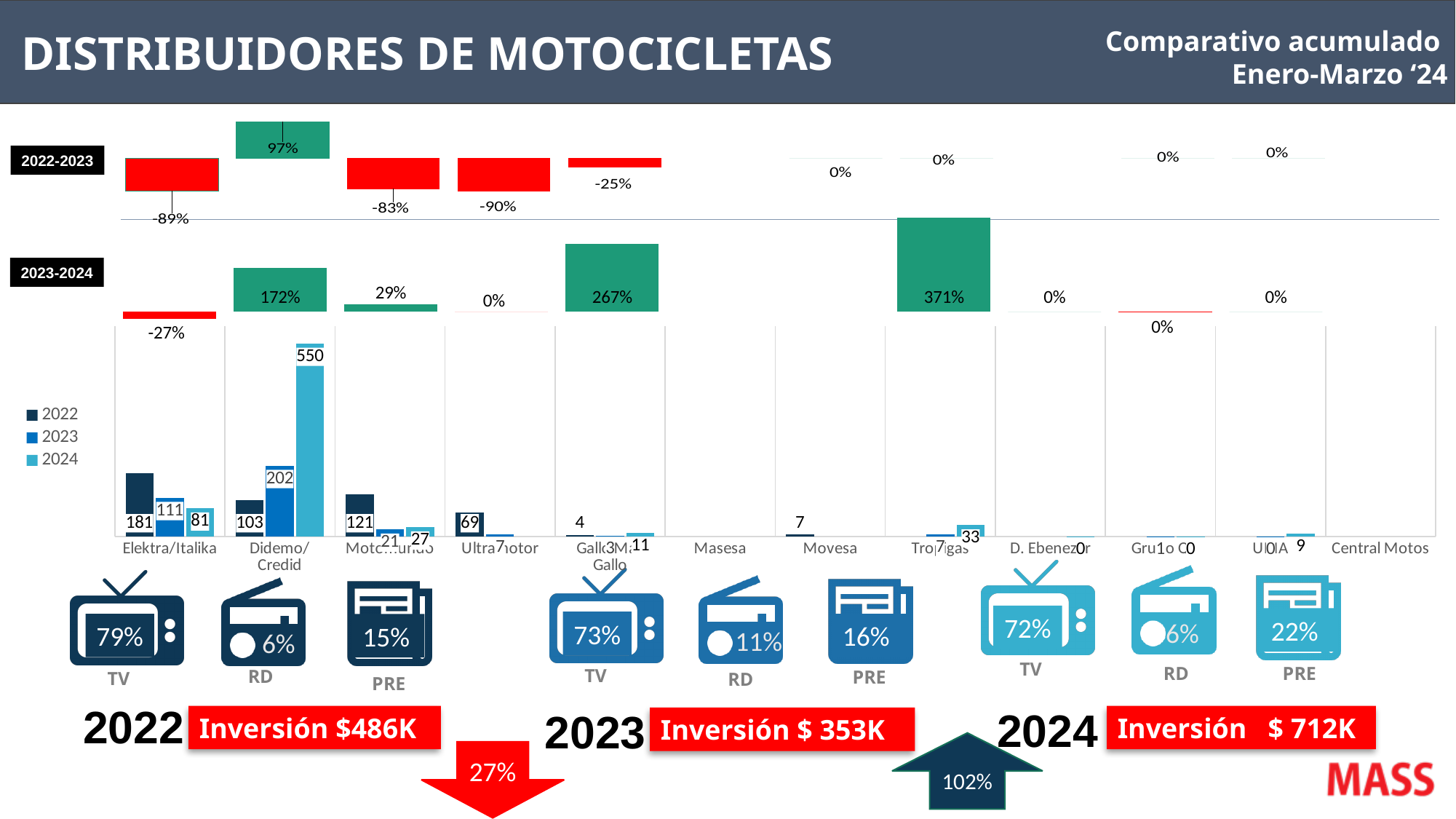
In the 2023-2024 comparison row, what is the percentage change shown for Tropigas? 371% In the bar chart, what is the difference between the 2024 and 2023 values for Didemo/Credid? 348 What kind of chart is used to show the 2022, 2023 and 2024 values per distributor? Bar chart In the bar chart, what is the 2024 value for Tropigas? 33 In the 2022-2023 comparison row, what is the percentage change shown for Ultramotor? -90% In the bar chart, which is larger: the 2022 value for Elektra/Italika or the 2022 value for Motomundo? Elektra/Italika How many series does the legend of the bar chart list? 3 How many distributor categories are shown on the x axis of the bar chart? 12 In the bar chart, which distributor has the highest 2024 value? Didemo/Credid In the bar chart, do the values for Elektra/Italika rise or fall from 2022 to 2024? Fall In the bar chart, what is the 2024 value for Didemo/Credid? 550 In the bar chart, what is the 2022 value for Elektra/Italika? 181